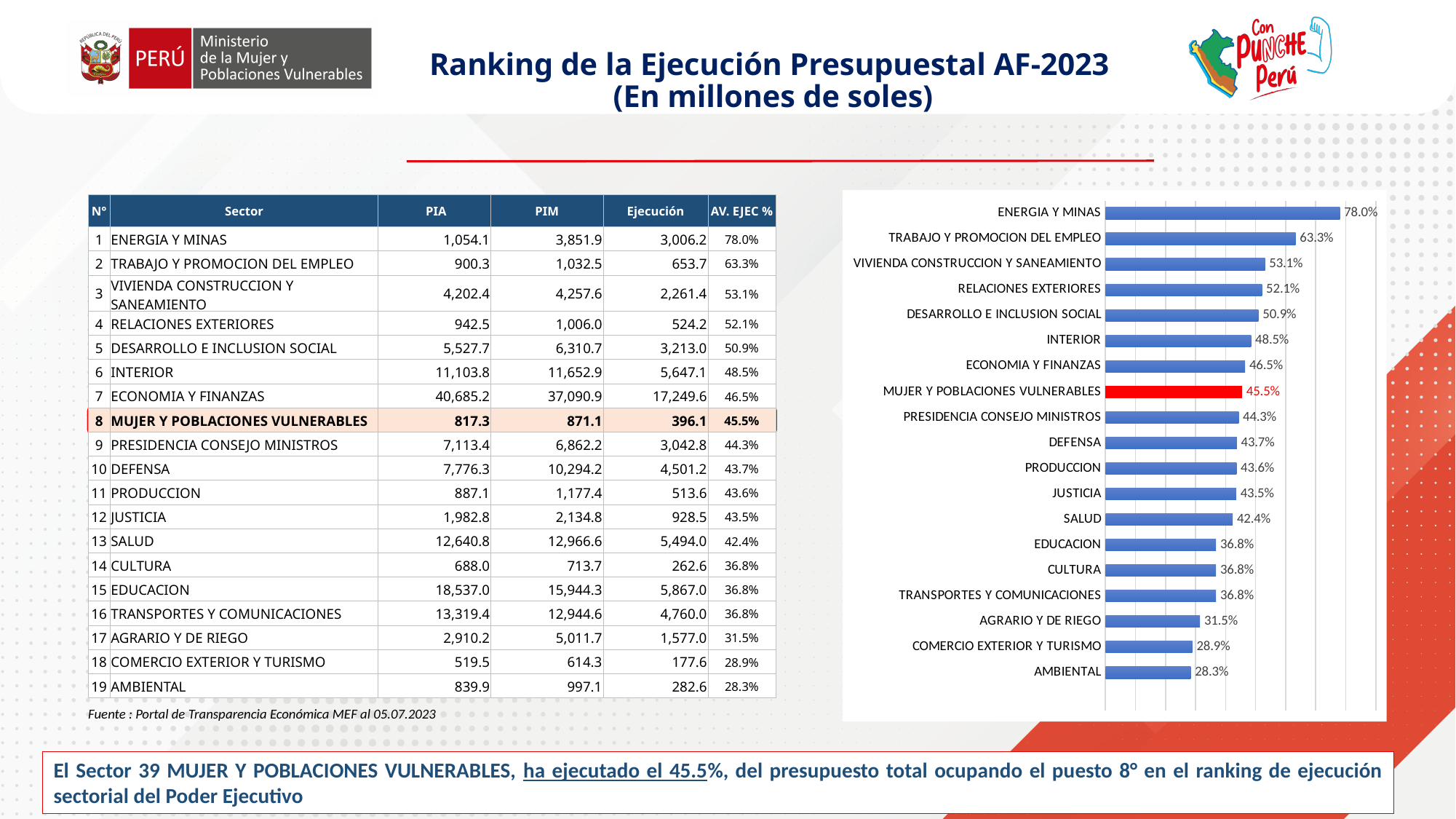
Which sector's bar is coloured red in the bar chart? MUJER Y POBLACIONES VULNERABLES What is the value shown for AGRARIO Y DE RIEGO in the bar chart? 31.5% What is the value shown for MUJER Y POBLACIONES VULNERABLES in the bar chart? 45.5% Which has a larger value in the bar chart, INTERIOR or ECONOMIA Y FINANZAS? INTERIOR What is the difference between the values for ENERGIA Y MINAS and TRABAJO Y PROMOCION DEL EMPLEO in the bar chart? 14.7 percentage points How many sectors are plotted in the bar chart? 19 What is the difference between the values for MUJER Y POBLACIONES VULNERABLES and AMBIENTAL in the bar chart? 17.2 percentage points What type of chart is shown on the right side of the slide? Bar chart Which sector has the highest value in the bar chart? ENERGIA Y MINAS What is the value shown for SALUD in the bar chart? 42.4% Which sector has the lowest value in the bar chart? AMBIENTAL What is the value shown for ENERGIA Y MINAS in the bar chart? 78.0%